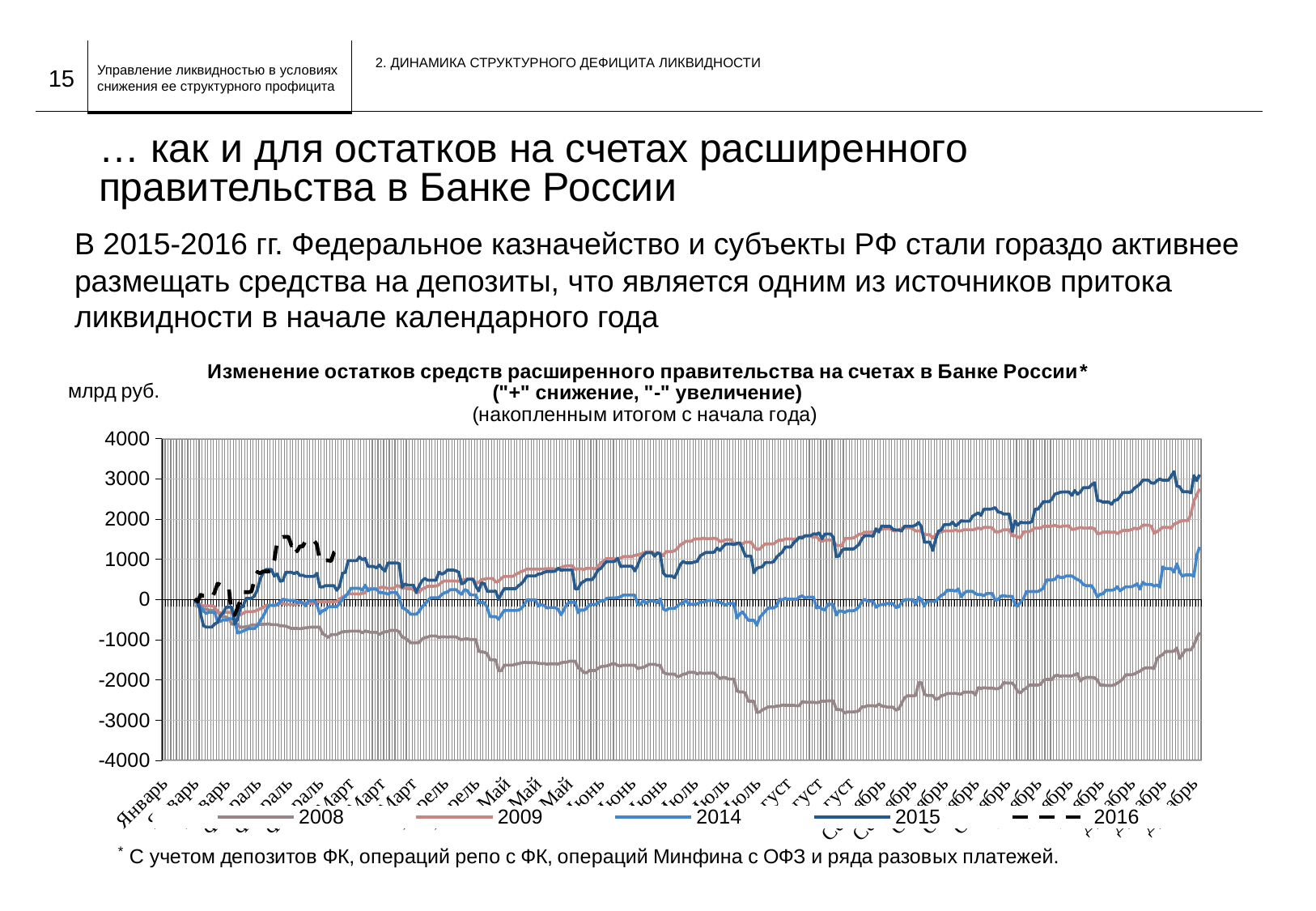
At the end of December, which series is lower: 2008 or 2015? 2008 What is the unit shown for the vertical axis of the chart? млрд руб. Does the 2015 series generally rise or fall over the course of the year? rise What is the maximum value shown on the vertical axis? 4000 Which years are listed in the chart legend? 2008, 2009, 2014, 2015, 2016 What is the minimum value shown on the vertical axis? -4000 Is the value of the 2008 series at the end of December greater or less than 0? less Which series is drawn with a dashed line? 2016 Is the value of the 2015 series at the end of December greater or less than 2000? greater How many series does the chart legend list? 5 Is the lowest point of the 2008 series greater or less than -2000? less What kind of chart is shown on the slide? line chart